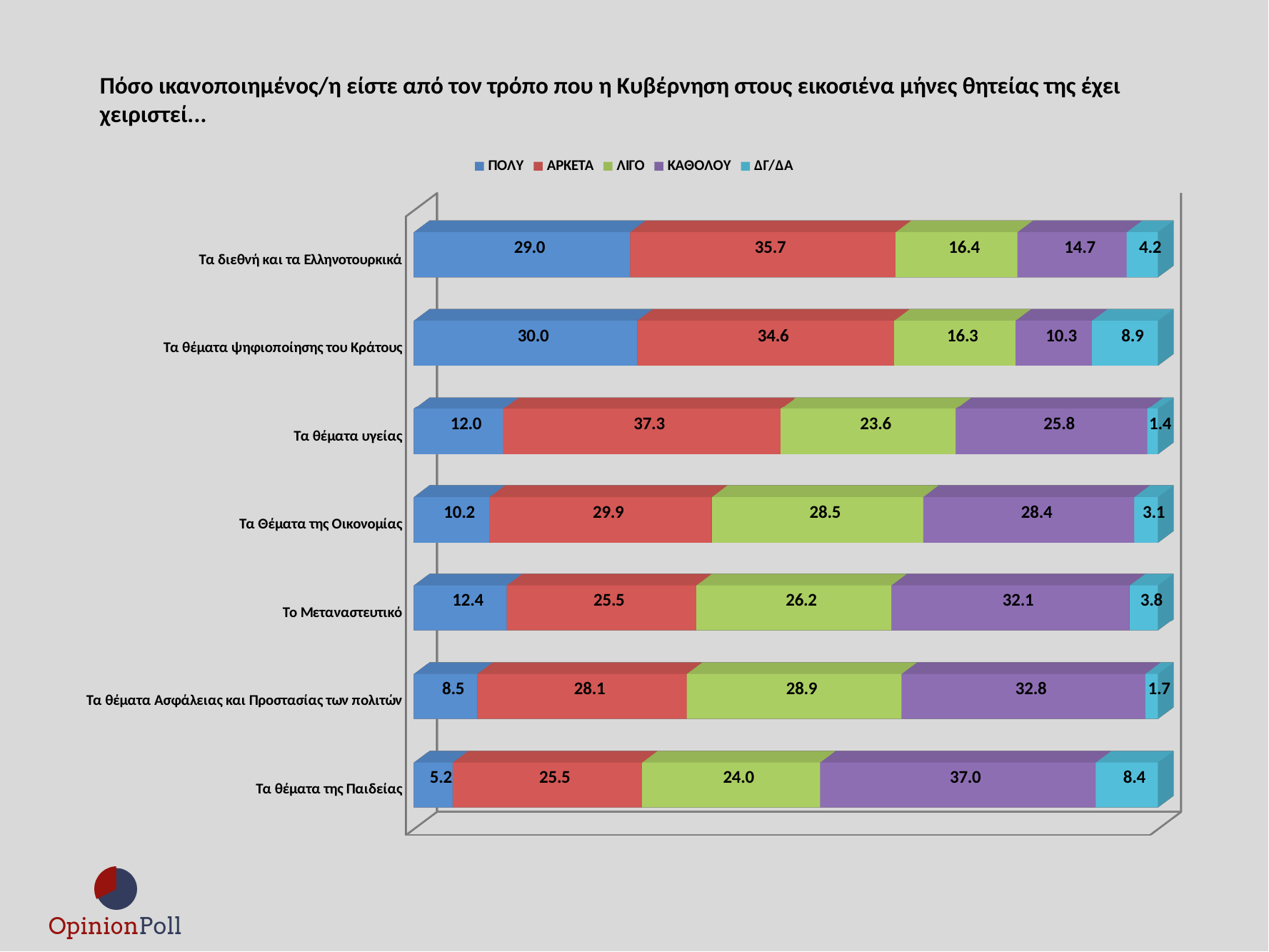
How many categories are shown in the chart? 7 What is the value of ΔΓ/ΔΑ for Τα θέματα ψηφιοποίησης του Κράτους? 8.9 Which category has the lowest ΠΟΛΥ value? Τα θέματα της Παιδείας Which has the larger ΛΙΓΟ value: Τα Θέματα της Οικονομίας or Τα θέματα Ασφάλειας και Προστασίας των πολιτών? Τα θέματα Ασφάλειας και Προστασίας των πολιτών Which category has the highest ΠΟΛΥ value? Τα θέματα ψηφιοποίησης του Κράτους Which category has the highest ΚΑΘΟΛΟΥ value? Τα θέματα της Παιδείας What is the total of the stacked bar for Το Μεταναστευτικό? 100.0 How many series does the legend list? 5 What is the difference between the ΑΡΚΕΤΑ value for Τα θέματα υγείας and the ΑΡΚΕΤΑ value for Το Μεταναστευτικό? 11.8 What is the value of ΚΑΘΟΛΟΥ for Τα θέματα της Παιδείας? 37.0 What is the value of ΠΟΛΥ for Τα θέματα υγείας? 12.0 What kind of chart is shown on the slide? Stacked bar chart